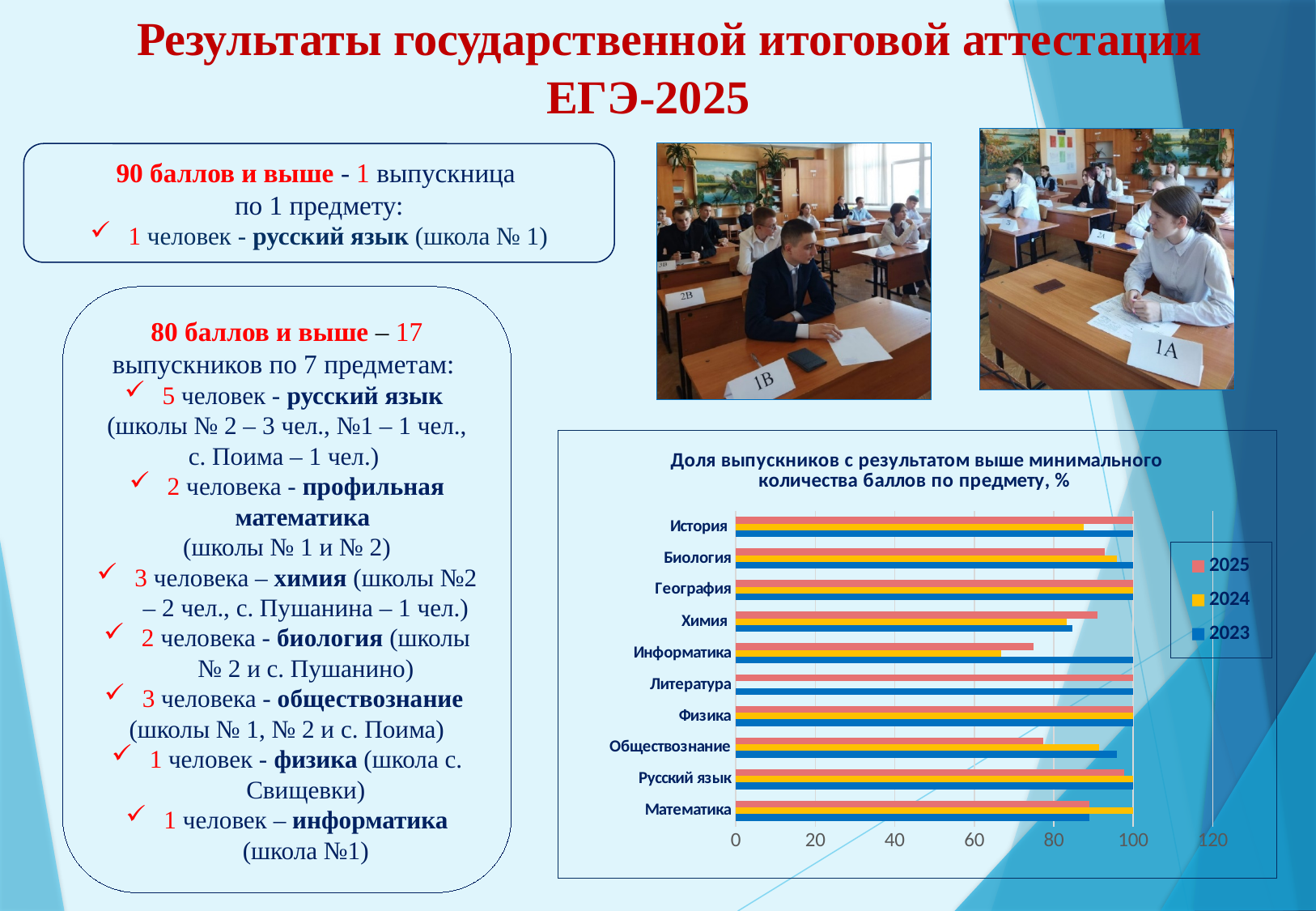
Is the 2023 value for Химия greater or less than 80? greater Is the 2025 value for Обществознание greater or less than 80? less Is the 2025 value for Информатика greater or less than 80? less What is the title of the chart on the slide? Доля выпускников с результатом выше минимального количества баллов по предмету, % What kind of chart is shown on the slide? bar chart Which years are listed in the chart legend? 2025, 2024, 2023 For Информатика, which year has the lowest value? 2024 How many series does the chart legend list? 3 For Обществознание, which is larger: the 2025 value or the 2024 value? 2024 For Информатика, which is larger: the 2025 value or the 2023 value? 2023 How many subjects (categories) are shown on the chart? 10